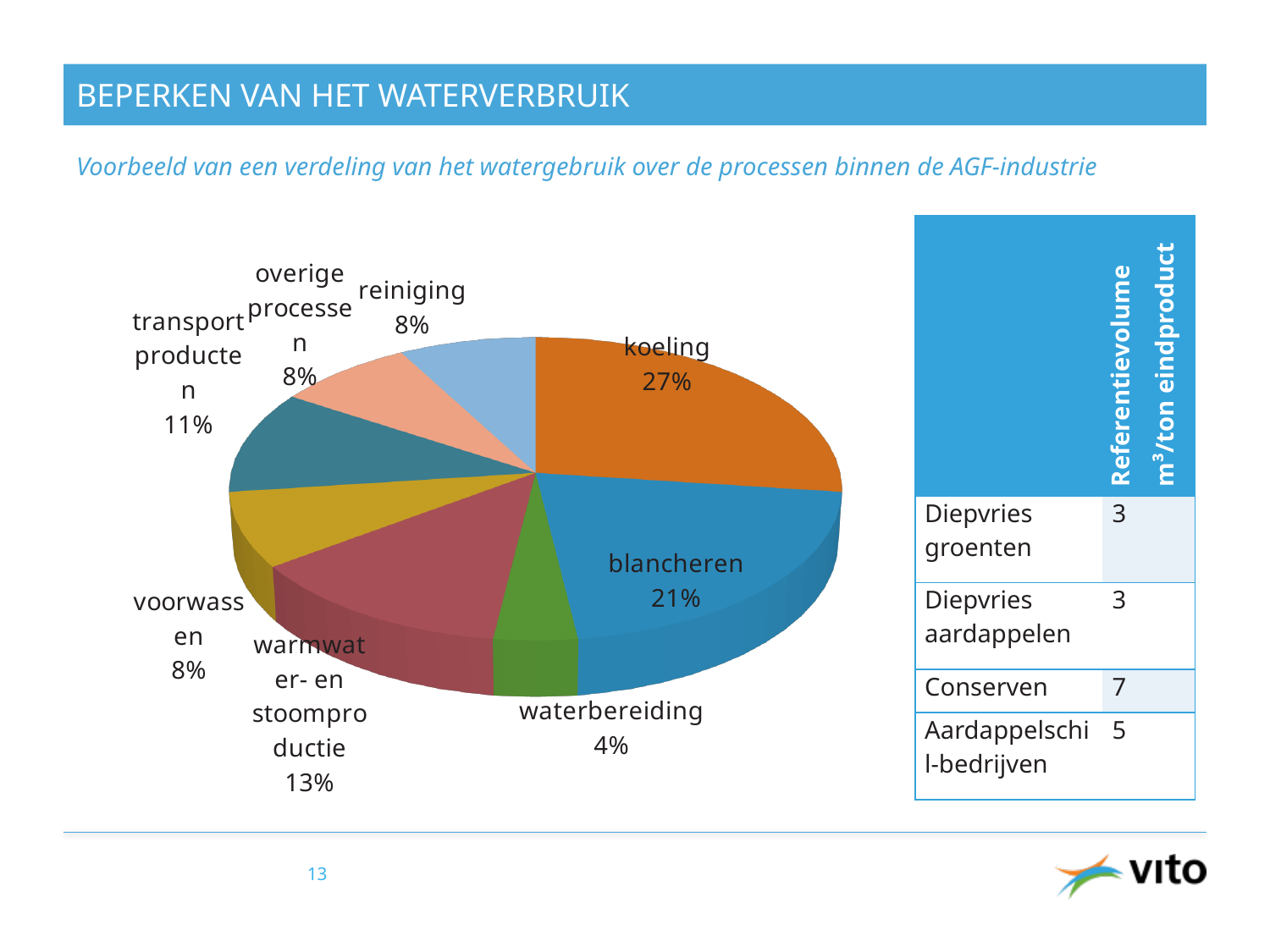
What share does warmwater- en stoomproductie have in the pie chart? 13% What is the difference in percentage points between koeling and blancheren in the pie chart? 6 Which process has the largest share in the pie chart? koeling Which has a larger share in the pie chart, transport producten or voorwassen? transport producten How many processes in the pie chart have a share of 8%? 3 What type of chart is shown on the slide? pie chart Which process has the smallest share in the pie chart? waterbereiding How many slices does the pie chart have? 8 What percentage is shown for transport producten in the pie chart? 11% What share of water use does koeling account for in the pie chart? 27% What percentage is shown for waterbereiding in the pie chart? 4% What percentage is shown for blancheren in the pie chart? 21%